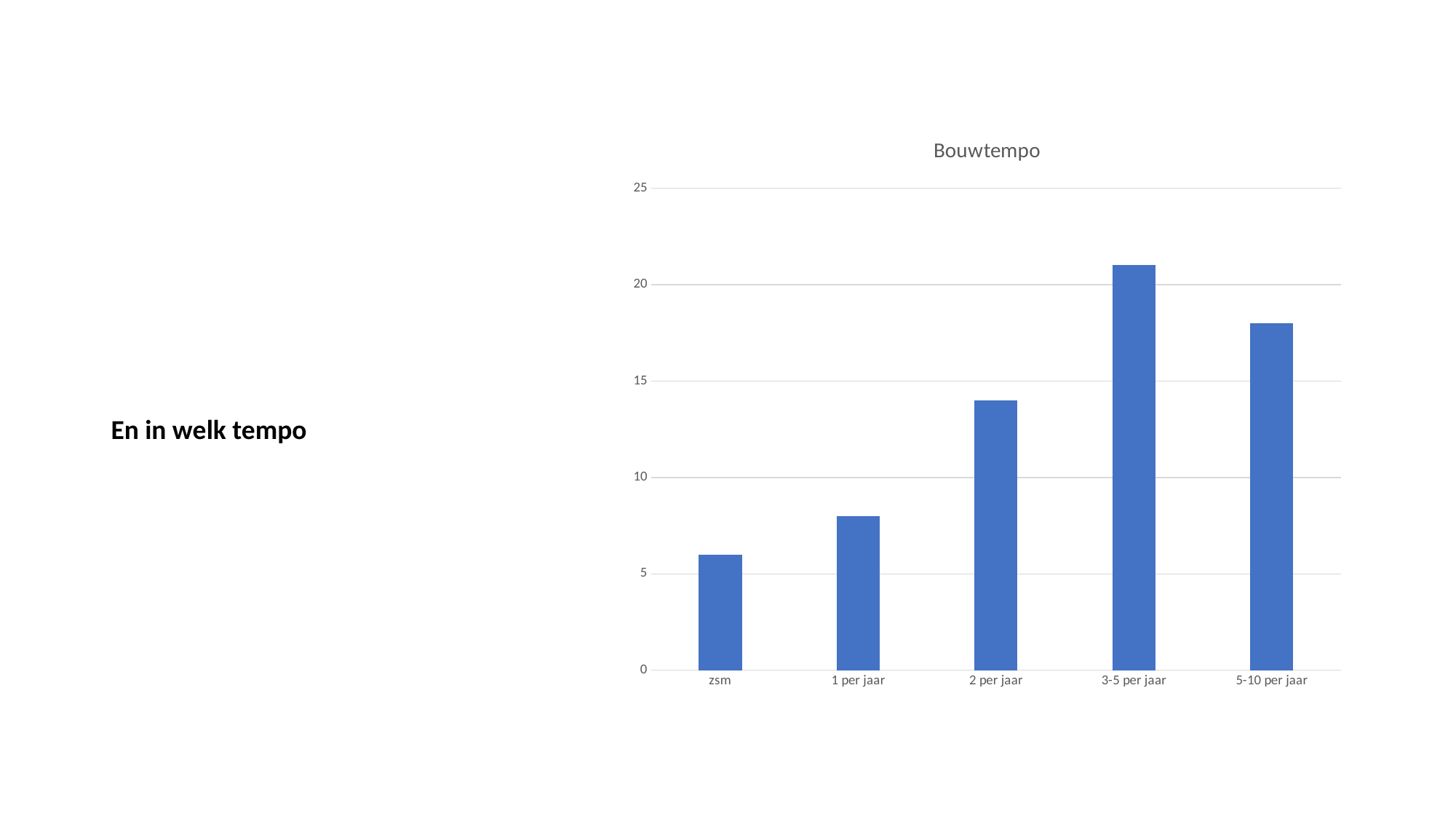
Which category has the lowest value in the chart? zsm Which category has the highest value in the chart? 3-5 per jaar Which is larger, the value for 3-5 per jaar or the value for 5-10 per jaar? 3-5 per jaar Which is larger, the value for zsm or the value for 1 per jaar? 1 per jaar Do the values rise or fall from zsm to 3-5 per jaar? rise Is the value for zsm greater or less than 5? greater How many categories are shown on the x axis of the chart? 5 What kind of chart is shown on the slide? bar chart Is the value for 3-5 per jaar greater or less than 20? greater Is the value for 1 per jaar greater or less than 10? less What is the title of the chart? Bouwtempo